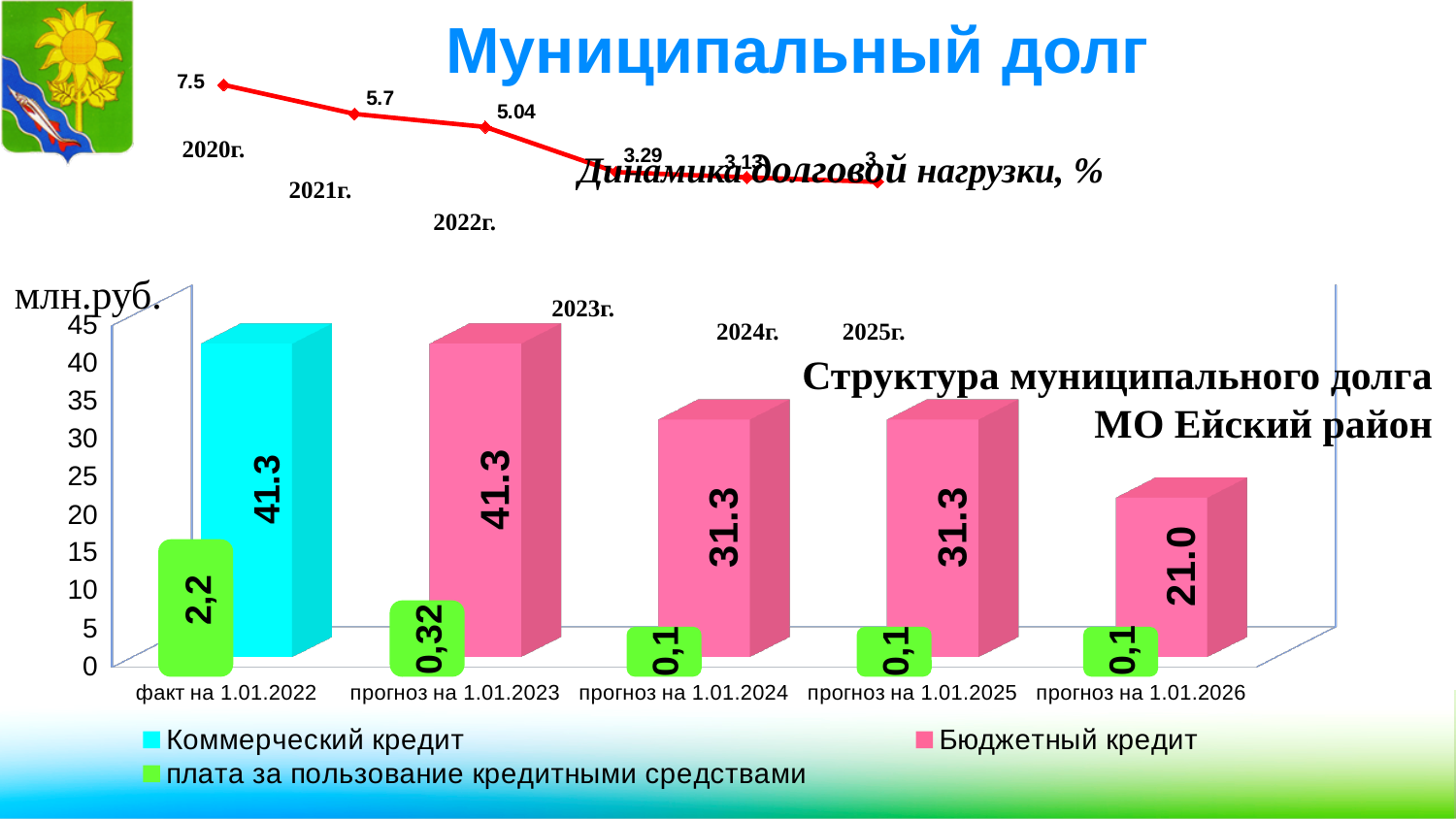
What kind of chart is 'Структура муниципального долга МО Ейский район'? bar chart On the chart 'Структура муниципального долга МО Ейский район', what is the value of Коммерческий кредит for факт на 1.01.2022? 41.3 How many categories are shown on the x axis of the chart 'Структура муниципального долга МО Ейский район'? 5 How many series does the legend of the chart 'Структура муниципального долга МО Ейский район' list? 3 On the line chart 'Динамика долговой нагрузки, %', what is the value for 2020г.? 7.5 On the line chart 'Динамика долговой нагрузки, %', which year has the highest value? 2020г. On the chart 'Структура муниципального долга МО Ейский район', what is the difference between Бюджетный кредит for прогноз на 1.01.2023 and for прогноз на 1.01.2026? 20.3 On the chart 'Структура муниципального долга МО Ейский район', what is the value of плата за пользование кредитными средствами for факт на 1.01.2022? 2,2 On the line chart 'Динамика долговой нагрузки, %', what is the value for 2022г.? 5.04 On the line chart 'Динамика долговой нагрузки, %', do the values rise or fall from 2020г. to 2025г.? fall On the line chart 'Динамика долговой нагрузки, %', what is the difference between the values for 2020г. and 2021г.? 1.8 On the chart 'Структура муниципального долга МО Ейский район', what is the value of Бюджетный кредит for прогноз на 1.01.2026? 21.0